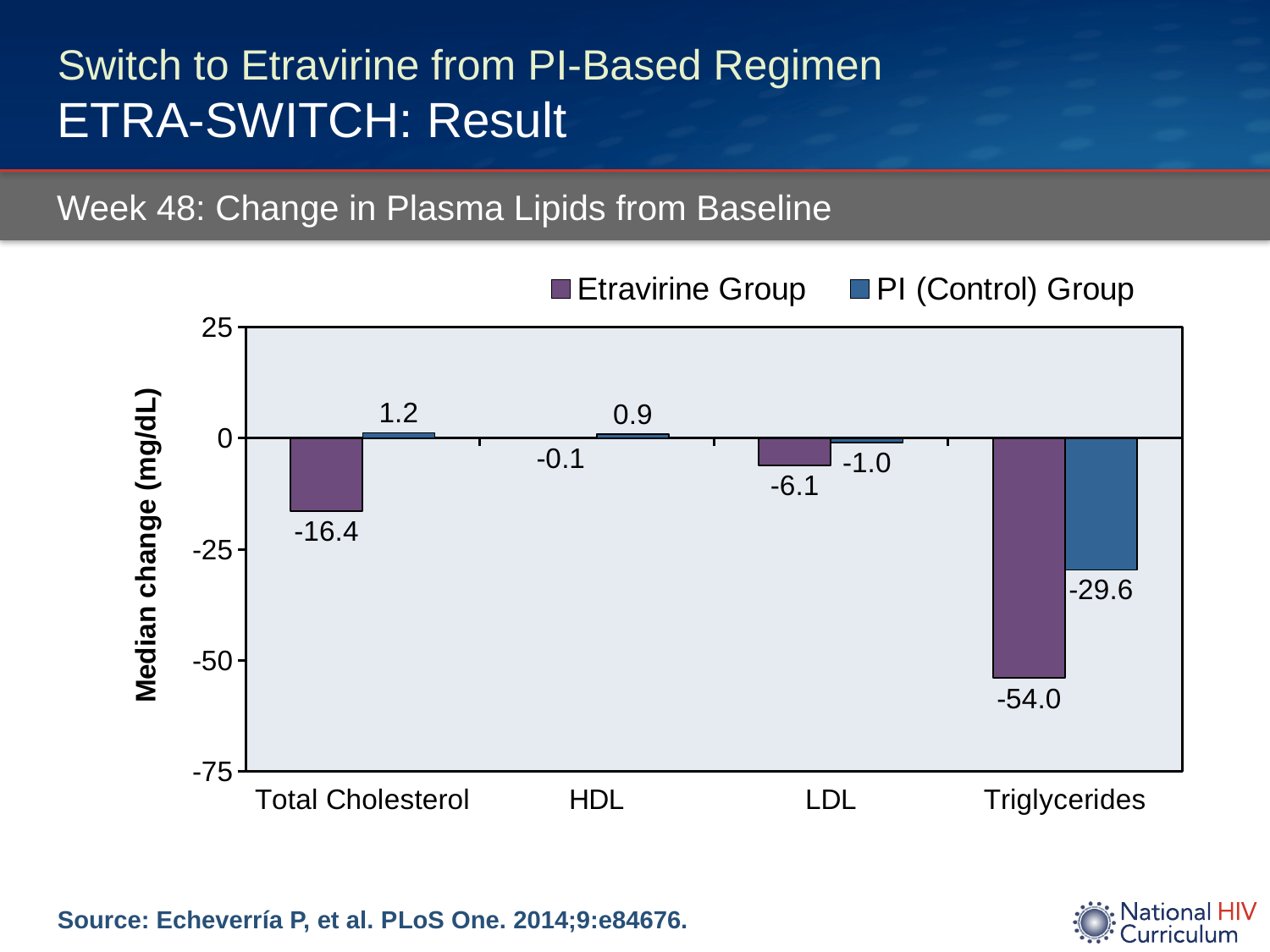
What is the label of the y axis? Median change (mg/dL) For LDL, which group has the larger decrease, Etravirine Group or PI (Control) Group? Etravirine Group Is the Etravirine Group value for Triglycerides greater or less than -50? less What kind of chart is shown on the slide? Bar chart What is the median change in LDL for the Etravirine Group? -6.1 What is the median change in Total Cholesterol for the Etravirine Group? -16.4 How many series does the legend list? 2 What is the median change in Triglycerides for the PI (Control) Group? -29.6 What is the median change in HDL for the PI (Control) Group? 0.9 Which lipid category shows the largest decrease for the Etravirine Group? Triglycerides How many lipid categories are shown on the x axis? 4 What is the difference between the Etravirine Group and PI (Control) Group values for Triglycerides? 24.4